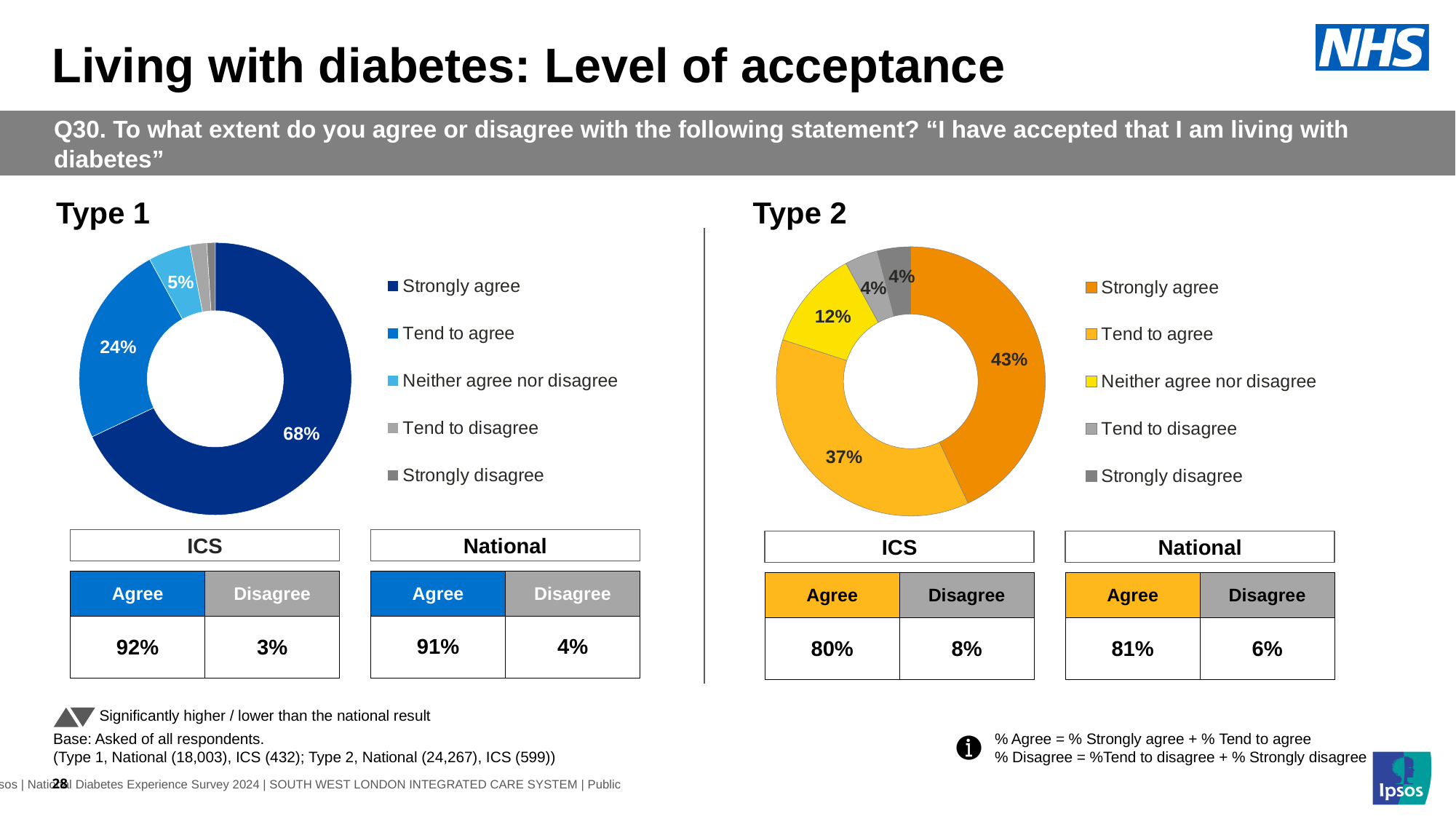
How many categories does the legend of the Type 2 chart list? 5 In the Type 2 chart, what percentage of respondents tend to agree? 37% In the Type 2 chart, what percentage of respondents strongly agree? 43% In the Type 1 chart, what colour represents Strongly agree? Dark blue In the Type 2 chart, what percentage neither agree nor disagree? 12% In the Type 2 chart, which is larger: Strongly agree or Neither agree nor disagree? Strongly agree In the Type 1 chart, which category has the largest share? Strongly agree In the Type 1 chart, what percentage of respondents tend to agree? 24% What kind of chart is used for the Type 1 data? Donut (pie) chart In the Type 1 chart, what percentage neither agree nor disagree? 5% In the Type 2 chart, what is the difference between the Strongly agree and Tend to agree shares? 6% In the Type 1 chart, what percentage of respondents strongly agree? 68%